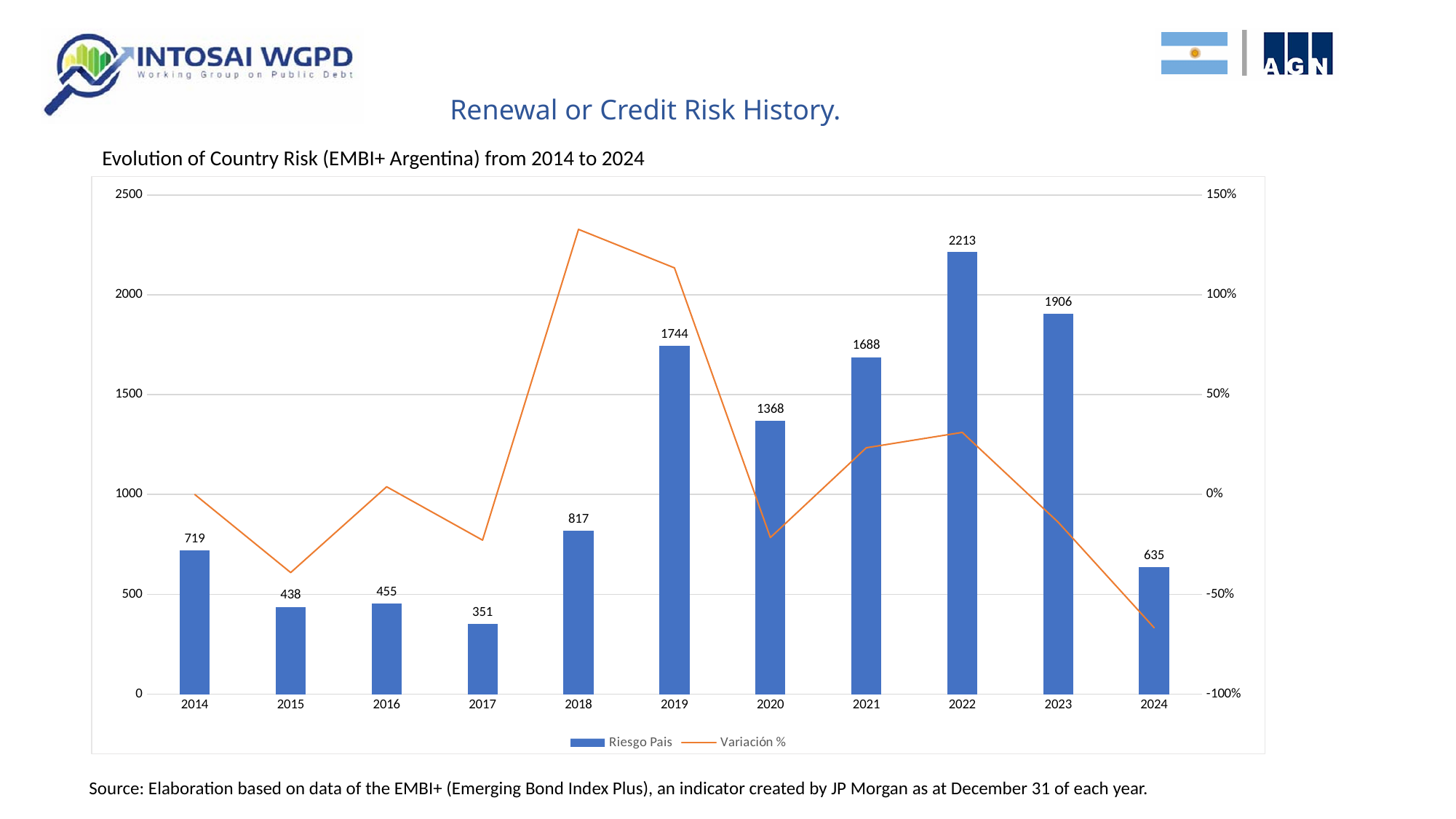
How many series does the legend list? 2 What is the Riesgo Pais value for 2019? 1744 Which is larger, the Riesgo Pais value for 2020 or for 2021? 2021 Which year has the highest Riesgo Pais value? 2022 Is the Variación % value for 2018 greater or less than 100%? greater What is the Riesgo Pais value for 2024? 635 Which year has the lowest Riesgo Pais value? 2017 What is the difference between the Riesgo Pais values for 2022 and 2023? 307 What is the Riesgo Pais value for 2017? 351 Is the Variación % value for 2024 greater or less than -50%? less How many years are shown on the x axis? 11 What is the title of the chart? Evolution of Country Risk (EMBI+ Argentina) from 2014 to 2024